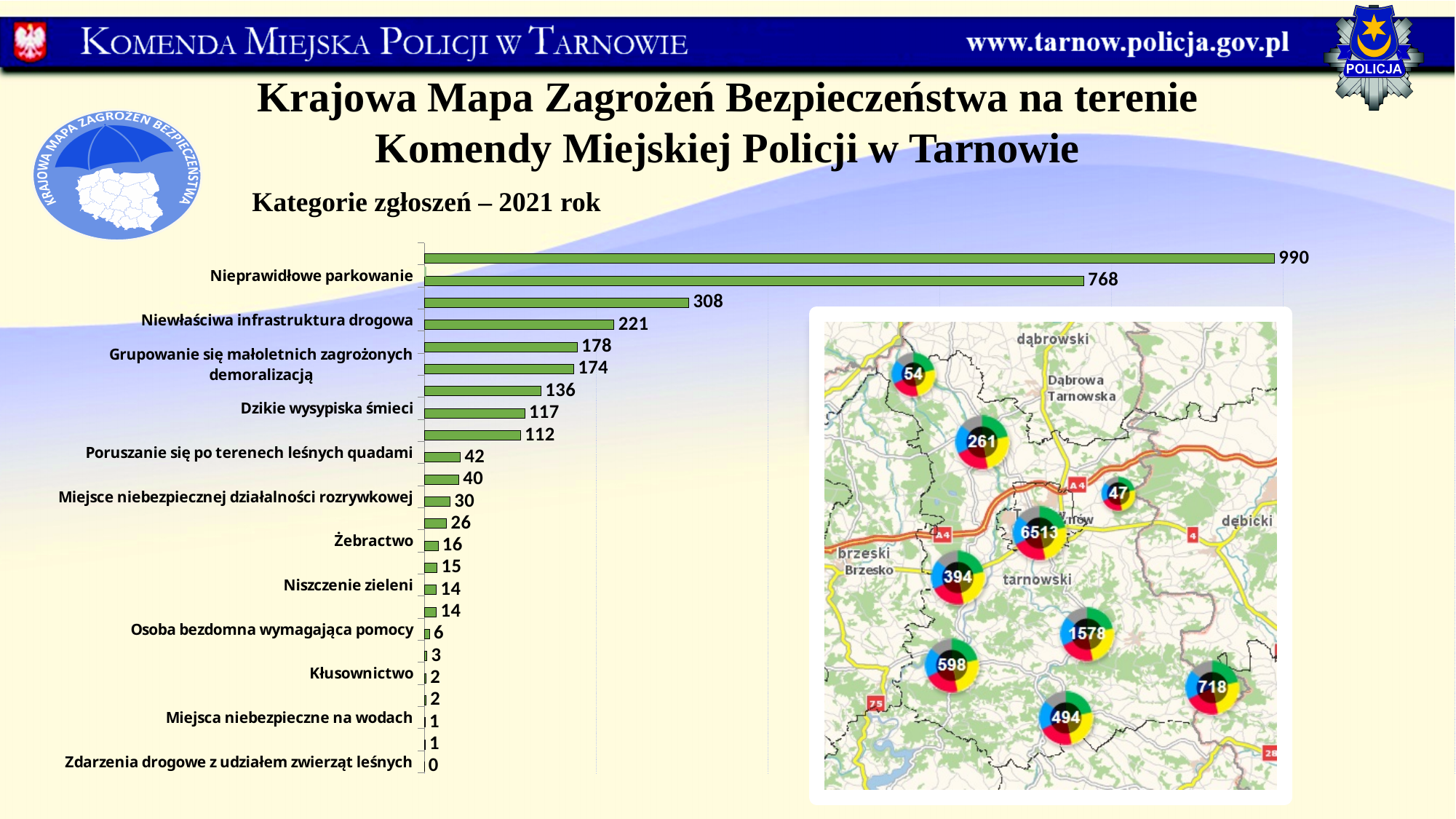
What is the value of the bar labelled Nieprawidłowe parkowanie? 768 How many bars have a value greater than 300? 3 How many bars are plotted in the chart? 24 What kind of chart is shown on the slide? bar chart What is the lowest value shown in the chart? 0 What colour are the bars in the chart? green What is the difference between the two longest bars (990 and 768)? 222 What is the highest value shown in the chart? 990 How many bars have the value 14? 2 What is the title of the chart? Kategorie zgłoszeń – 2021 rok What is the value for Zdarzenia drogowe z udziałem zwierząt leśnych? 0 Do the bar values increase or decrease from the top of the chart to the bottom? decrease